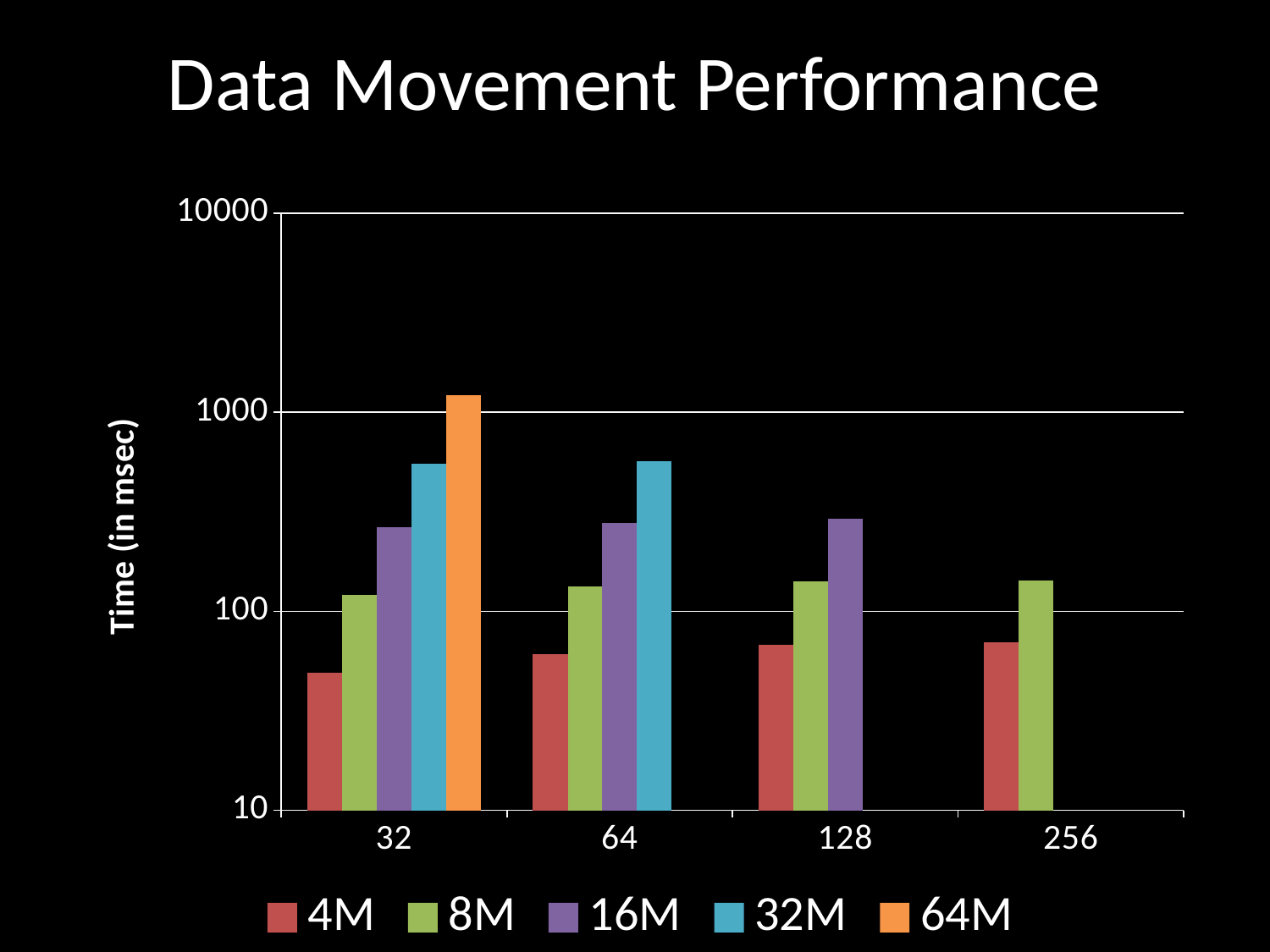
What is the title of the y axis? Time (in msec) Which is larger at 32: the value for 64M or the value for 32M? 64M How many series does the legend list? 5 Which series has the lowest value in the 32 category? 4M Is the value for 4M at 32 greater or less than 100? less Which is larger at 256: the value for 4M or the value for 8M? 8M Which series has the highest value in the 32 category? 64M How many categories are shown on the x axis? 4 Is the value for 16M at 128 greater or less than 100? greater Is the value for 32M at 64 greater or less than 1000? less What type of chart is shown on the slide? bar chart